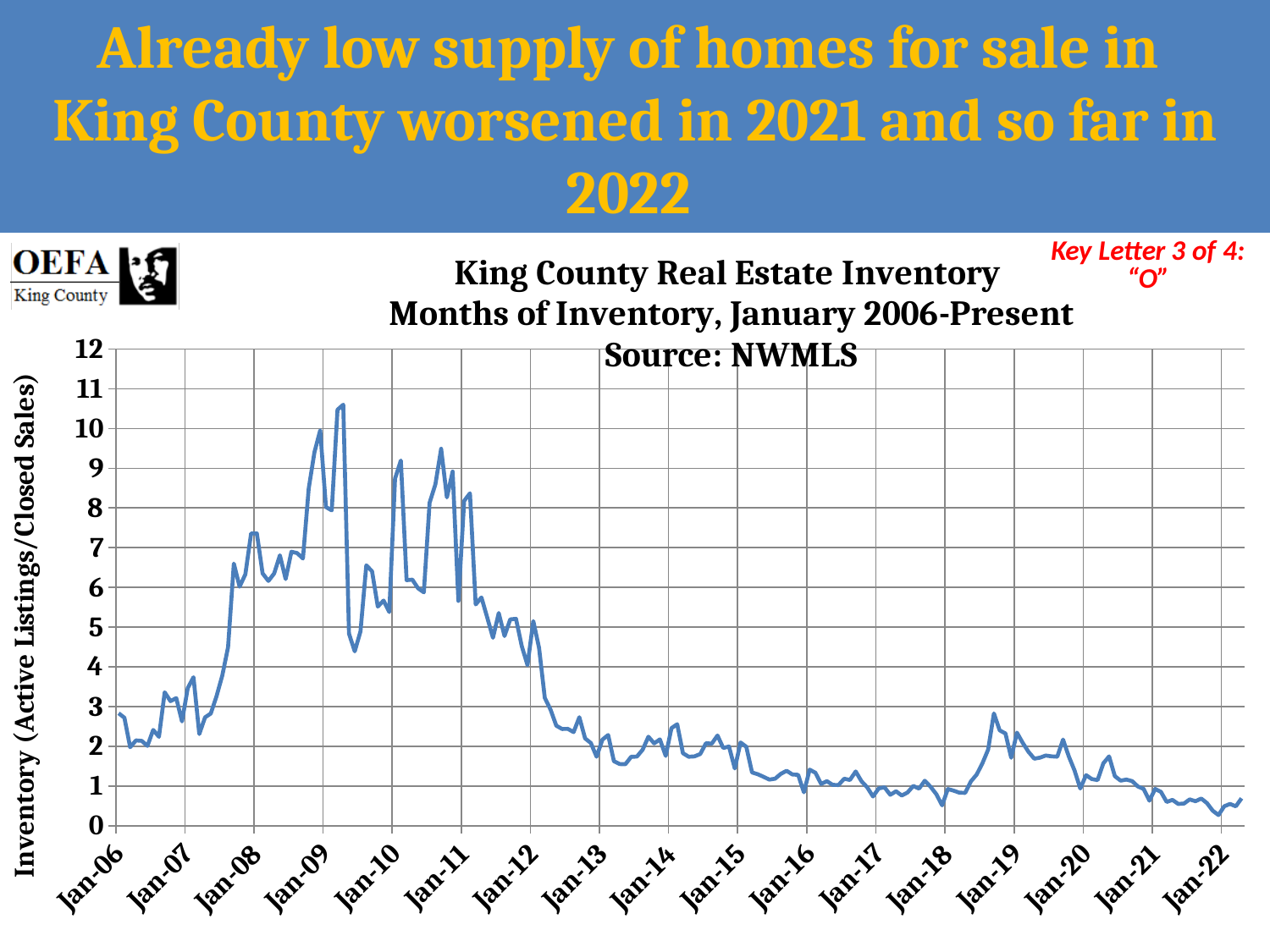
Does the line ever rise above 11 months of inventory? no Is the value for Jan-13 greater or less than 4? less Which is larger, the value at Jan-06 or the value at Jan-22? Jan-06 What kind of chart is shown on the slide? line chart Is the value for Jan-22 greater or less than 1? less What is the title of the chart? King County Real Estate Inventory Months of Inventory, January 2006-Present Source: NWMLS Does the line generally rise or fall between Jan-19 and Jan-22? fall In which year does the line reach its highest point? 2009 What is the label on the y axis of the chart? Inventory (Active Listings/Closed Sales)